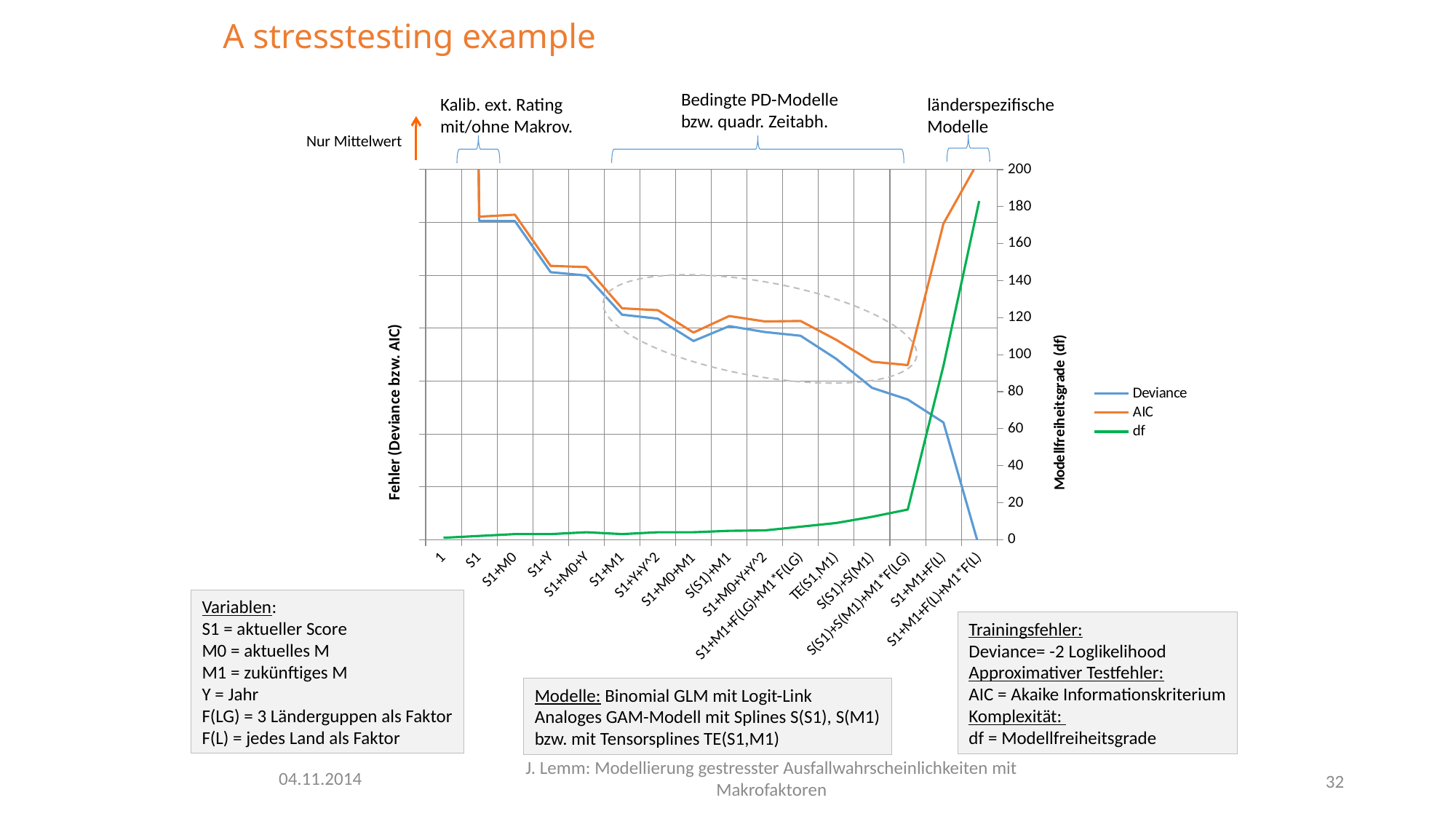
Which series are listed in the chart legend? Deviance, AIC, df Does the df series rise or fall along the x axis? rise What is the title of the right-hand vertical axis? Modellfreiheitsgrade (df) Is the df value for S(S1)+S(M1)+M1*F(LG) greater or less than 40? less Is the df value for S1+M1+F(L) greater or less than 100? less Which category has the highest df value? S1+M1+F(L)+M1*F(L) Is the df value for S1+M1+F(L)+M1*F(L) greater or less than 160? greater How many model categories are shown along the x axis of the chart? 16 What kind of chart is shown on the slide? line chart How many series does the chart legend list? 3 Which category has the lowest df value? 1 At S1+M1+F(L), which is larger: the AIC value or the Deviance value? AIC